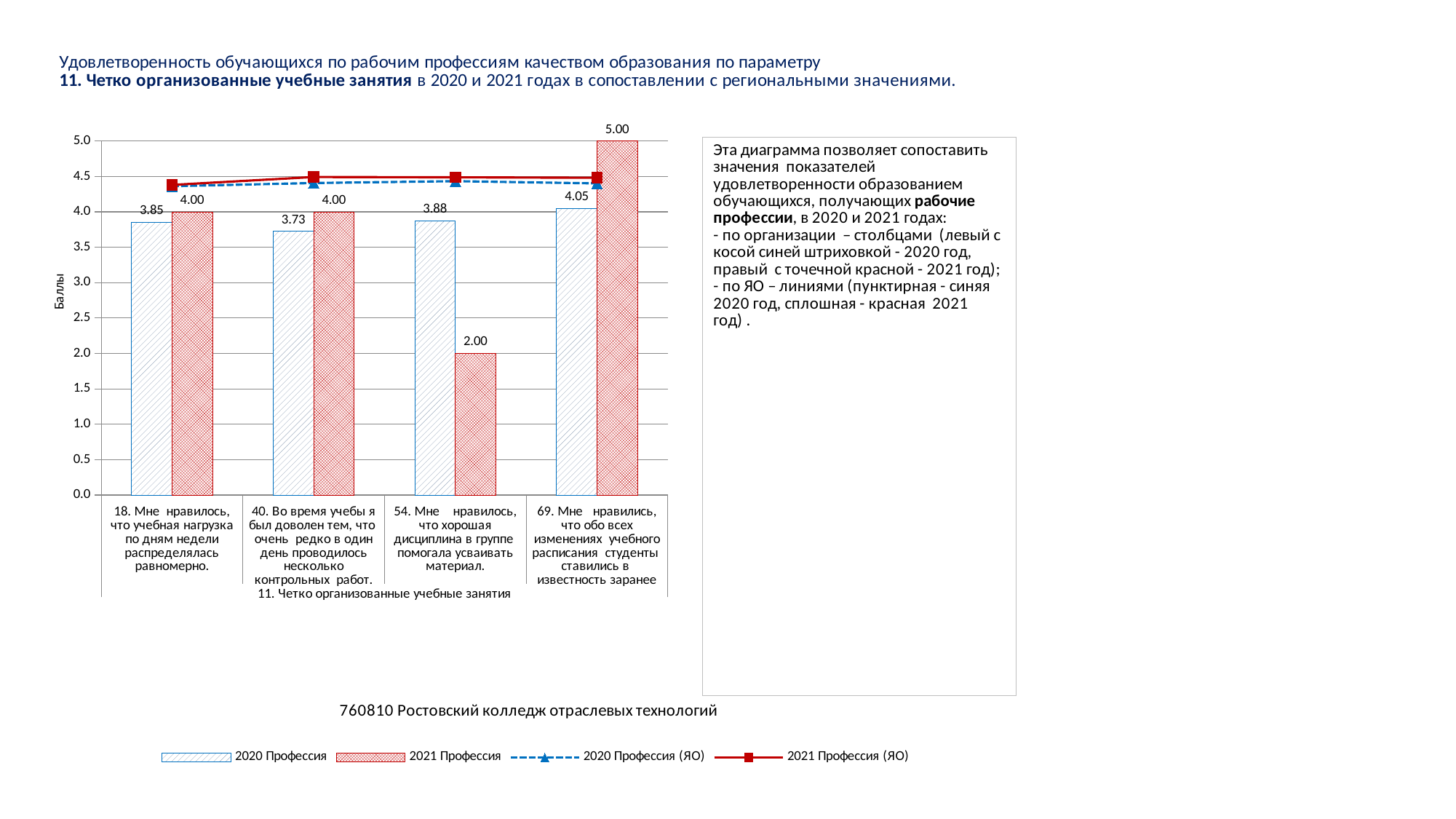
Which category has the lowest 2021 Профессия value? 54. Мне нравилось, что хорошая дисциплина в группе помогала усваивать материал How many categories are shown on the x axis? 4 Which category has the highest 2020 Профессия value? 69. Мне нравились, что обо всех изменениях учебного расписания студенты ставились в известность заранее What is the difference between the 2021 Профессия and 2020 Профессия values for category 69? 0.95 What is the label of the vertical axis? Баллы What is the value of the 2021 Профессия bar for category 54 (Мне нравилось, что хорошая дисциплина в группе помогала усваивать материал)? 2.00 Is the 2021 Профессия (ЯО) line value for category 18 greater or less than 4.0? greater For category 54, which is larger: the 2020 Профессия value or the 2021 Профессия value? 2020 Профессия What is the value of the 2020 Профессия bar for category 40 (Во время учебы я был доволен тем, что очень редко в один день проводилось несколько контрольных работ)? 3.73 What is the value of the 2021 Профессия bar for category 69 (Мне нравились, что обо всех изменениях учебного расписания студенты ставились в известность заранее)? 5.00 How many series does the legend list? 4 What is the value of the 2020 Профессия bar for category 18 (Мне нравилось, что учебная нагрузка по дням недели распределялась равномерно)? 3.85